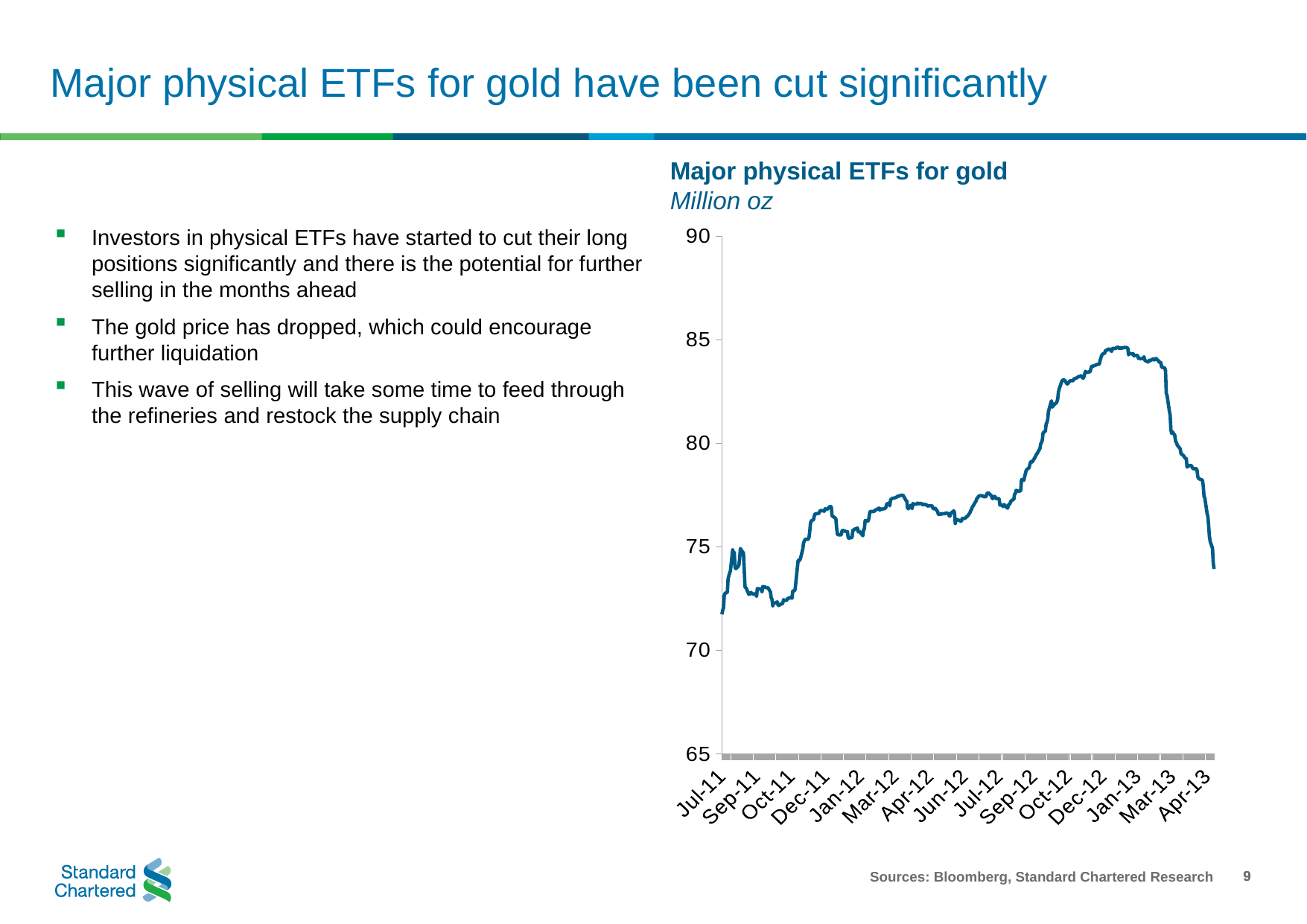
Around which labelled month does the line reach its highest point? Dec-12 What is the title of the chart? Major physical ETFs for gold Is the value at Oct-12 greater or less than 80? greater Is the value at Jul-11 greater or less than 75? less Does the line rise or fall between Dec-12 and Apr-13? fall What kind of chart is shown on the slide? line chart Is the value at Jan-12 greater or less than 75? greater What unit is the chart's data measured in, as stated under the title? Million oz How many month labels are shown on the x axis? 15 Does the line rise or fall between Jul-11 and Dec-12? rise